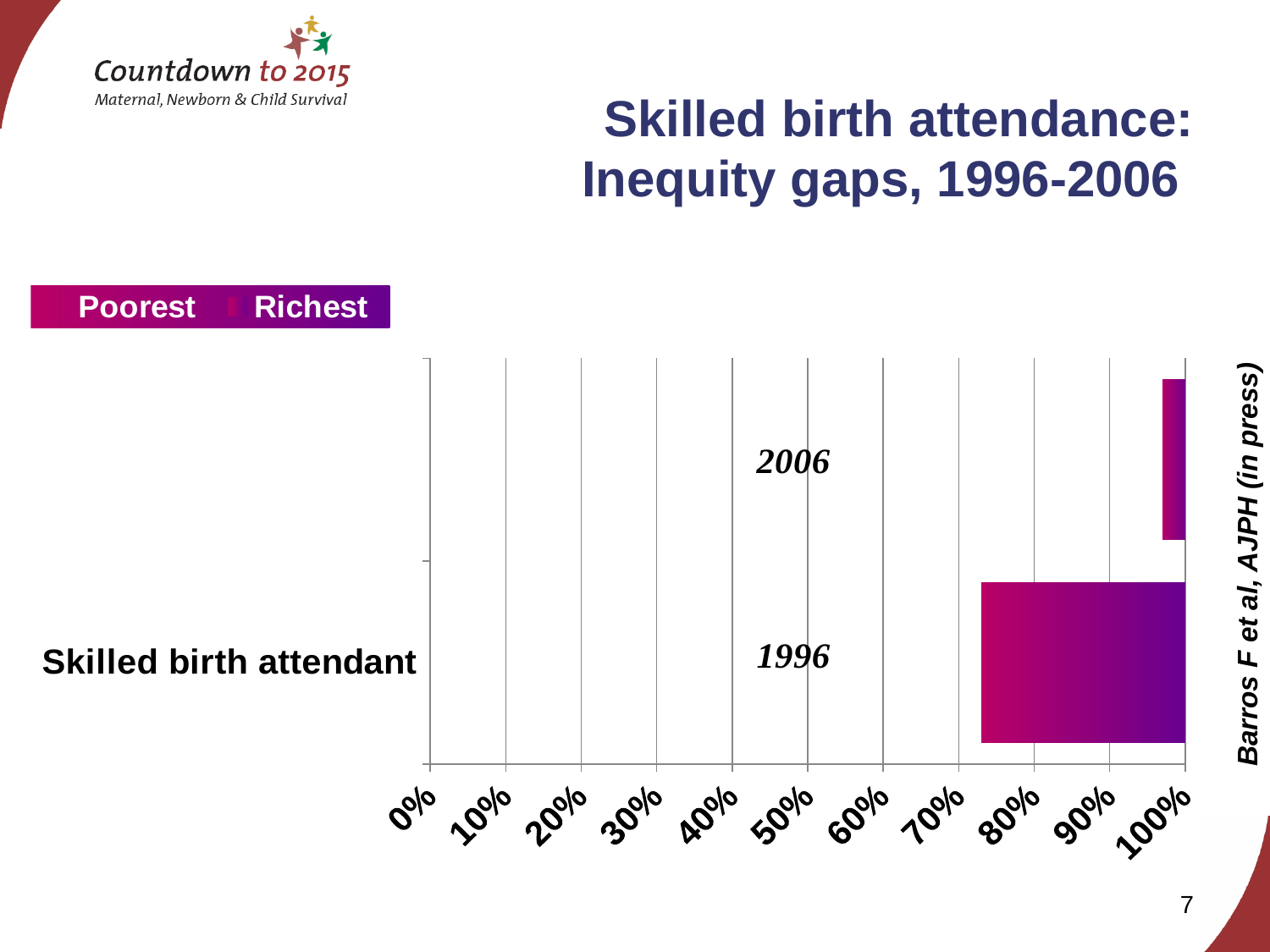
What are the two legend entries in the chart? Poorest and Richest What is the title of the slide's chart? Skilled birth attendance: Inequity gaps, 1996-2006 Is the poorest value for 1996 greater or less than 70%? greater Which year shows the narrower gap between poorest and richest? 2006 What is the highest value shown on the x axis? 100% How many bars are plotted in the chart? 2 What kind of chart is shown on the slide? bar chart How many entries does the legend list? 2 Did the inequity gap in skilled birth attendance widen or narrow from 1996 to 2006? narrow Is the poorest value for 2006 greater or less than 90%? greater Is the poorest value for 1996 greater or less than 80%? less Which year shows the wider gap between poorest and richest for skilled birth attendance? 1996